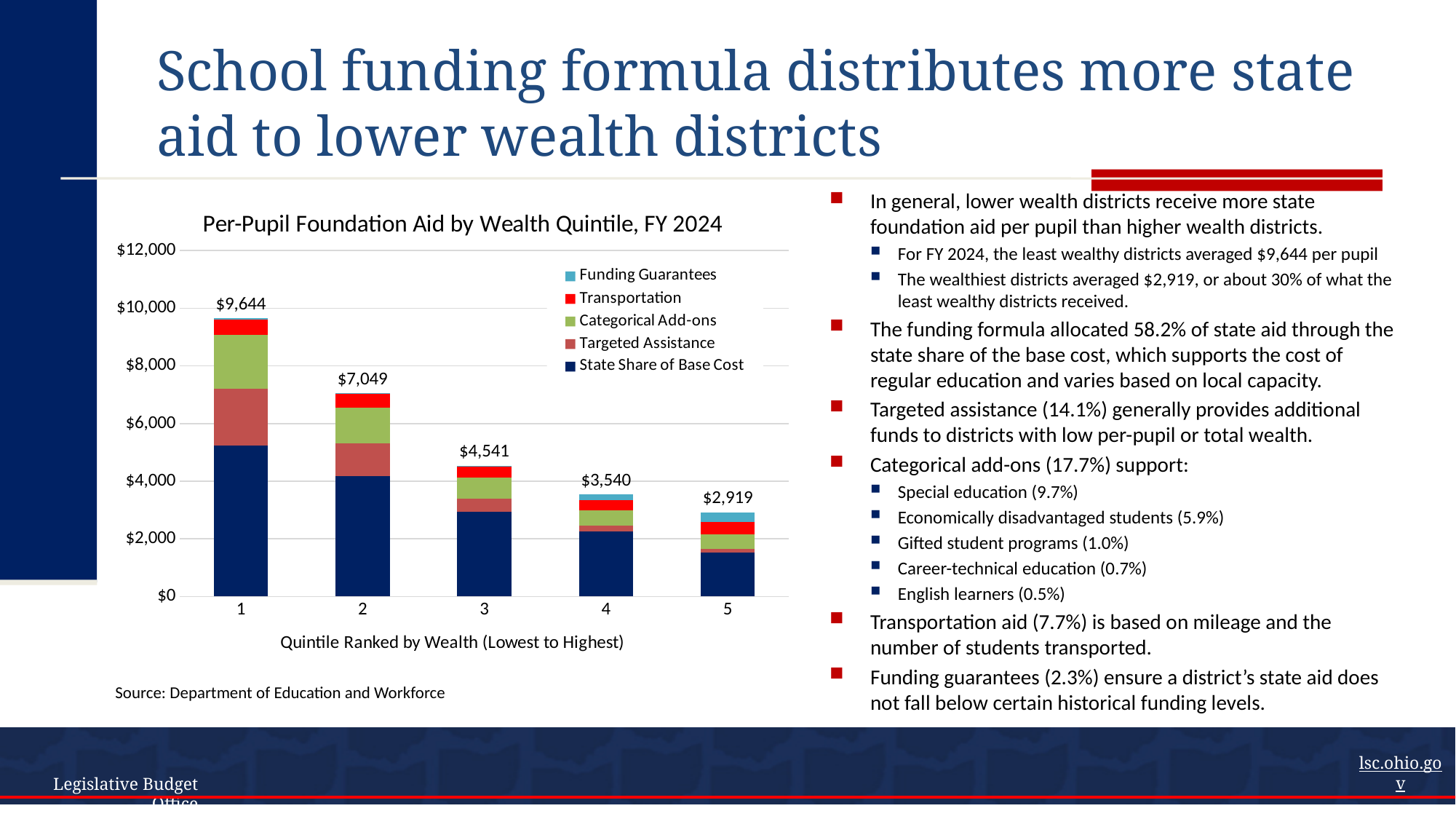
Which quintile has the highest total per-pupil foundation aid? 1 How many series does the legend list? 5 What is the difference between the total per-pupil aid for quintile 2 and quintile 3? $2,508 What is the total per-pupil foundation aid for quintile 1? $9,644 Is the State Share of Base Cost for quintile 5 greater or less than $2,000? less Which has a larger total per-pupil aid, quintile 2 or quintile 4? Quintile 2 Which quintile has the lowest total per-pupil foundation aid? 5 What is the difference between the total per-pupil aid for quintile 1 and quintile 5? $6,725 What is the total per-pupil foundation aid for quintile 3? $4,541 Is the State Share of Base Cost for quintile 1 greater or less than $4,000? greater How many quintiles are shown on the x axis? 5 What is the total per-pupil foundation aid for quintile 5? $2,919